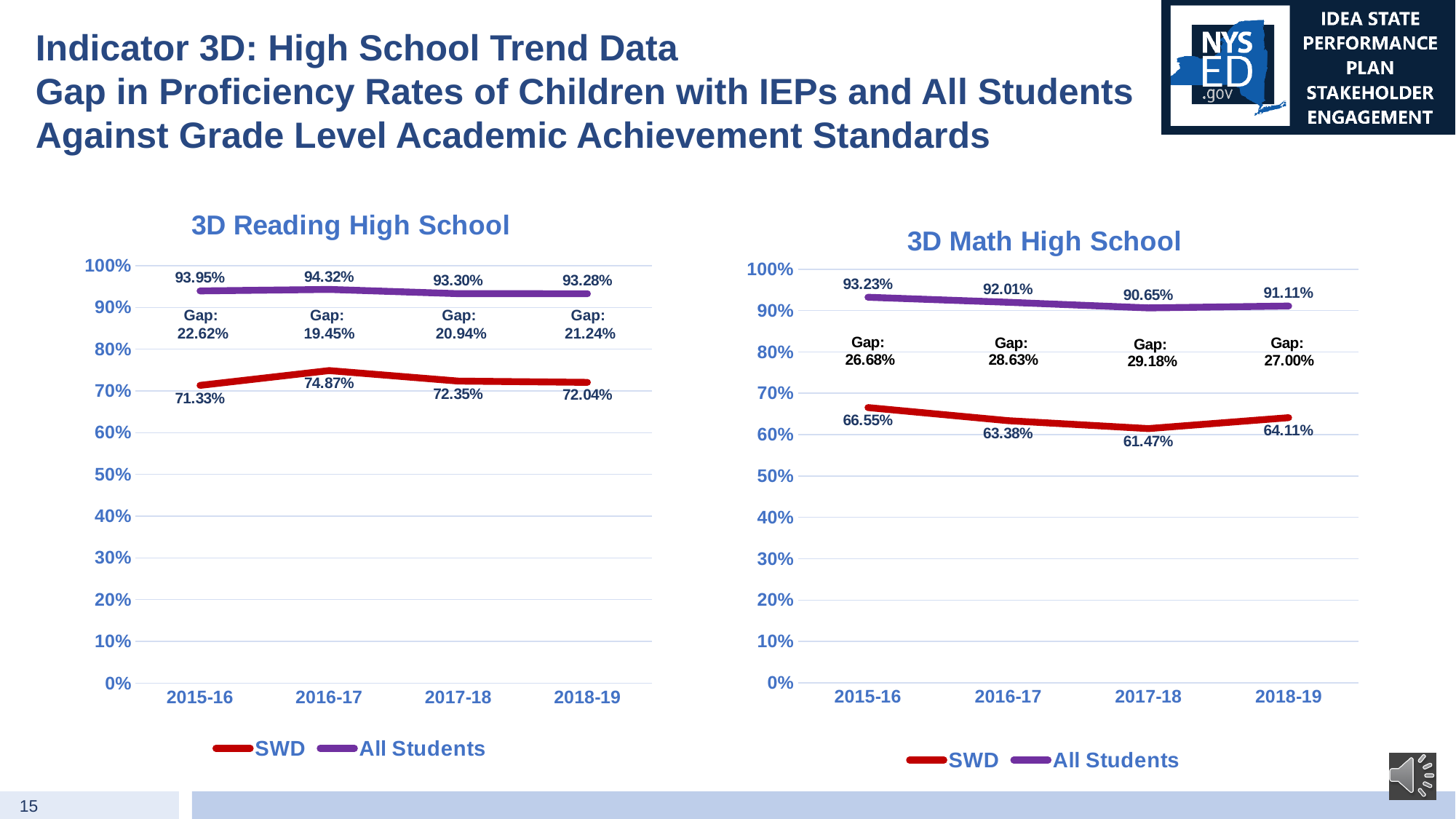
In the 3D Reading High School chart, which year has the highest SWD value? 2016-17 In the 3D Reading High School chart, is the SWD value for 2015-16 greater or less than 70%? greater In the 3D Math High School chart, which is larger: the SWD value for 2015-16 or the SWD value for 2018-19? 2015-16 In the 3D Reading High School chart, what is the SWD value for 2016-17? 74.87% In the 3D Math High School chart, what is the difference between the All Students and SWD values for 2015-16? 26.68% What kind of chart is the 3D Math High School chart? Line chart In the 3D Reading High School chart, what is the difference between the SWD values for 2016-17 and 2015-16? 3.54% How many years are shown on the x axis of the 3D Math High School chart? 4 In the 3D Math High School chart, what is the All Students value for 2017-18? 90.65% In the 3D Math High School chart, does the All Students line rise or fall from 2015-16 to 2017-18? Fall How many series does the legend of the 3D Reading High School chart list? 2 In the 3D Math High School chart, which year has the lowest SWD value? 2017-18